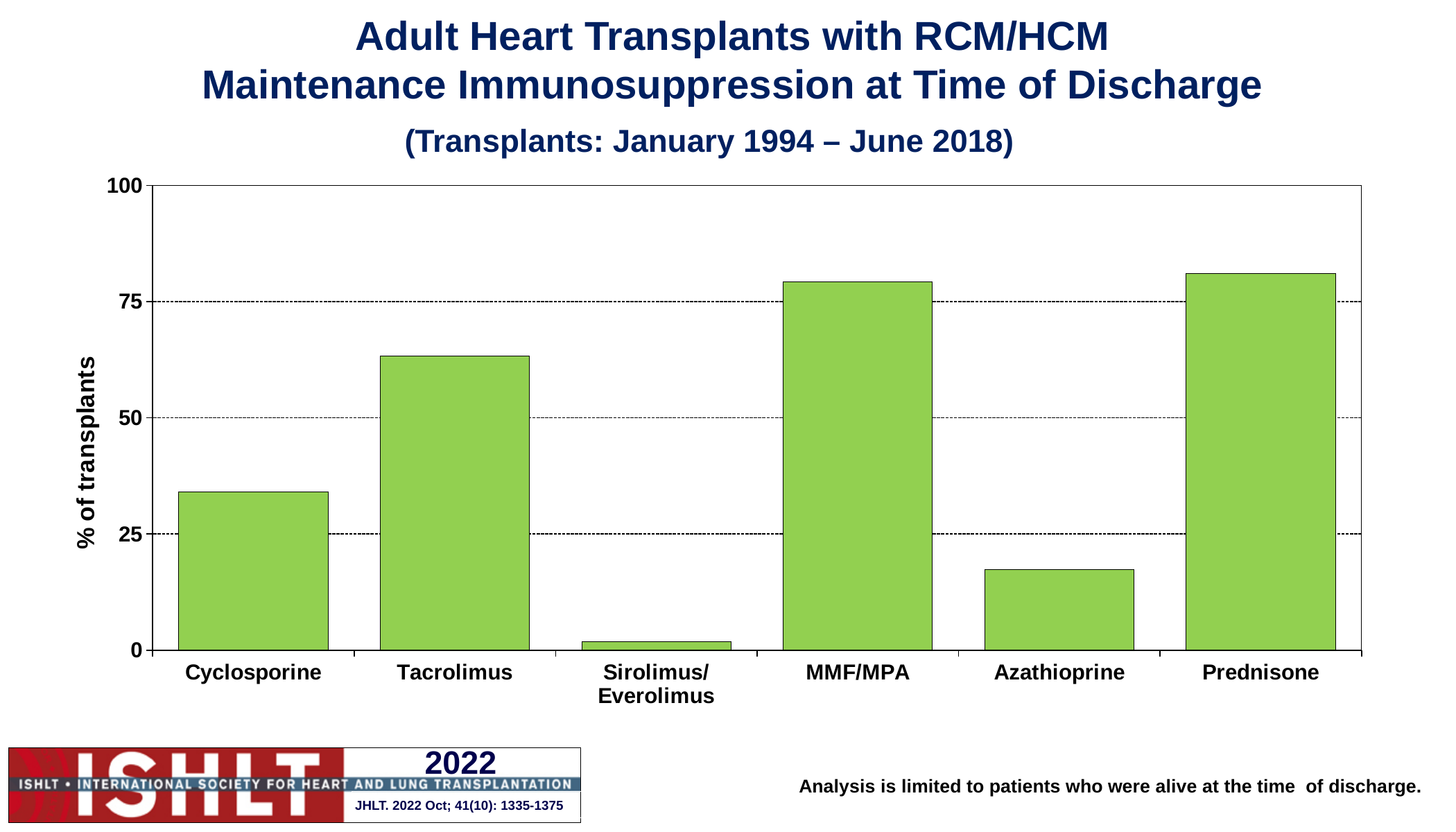
Which is larger, the value for Tacrolimus or the value for Cyclosporine? Tacrolimus Which category has the lowest % of transplants? Sirolimus/Everolimus Is the value for Tacrolimus greater or less than 50? greater Is the value for Cyclosporine greater or less than 50? less How many immunosuppression categories are shown on the x axis? 6 What is the label on the y axis of the chart? % of transplants Is the value for MMF/MPA greater or less than 75? greater What kind of chart is shown on the slide? bar chart Which is larger, the value for Azathioprine or the value for MMF/MPA? MMF/MPA